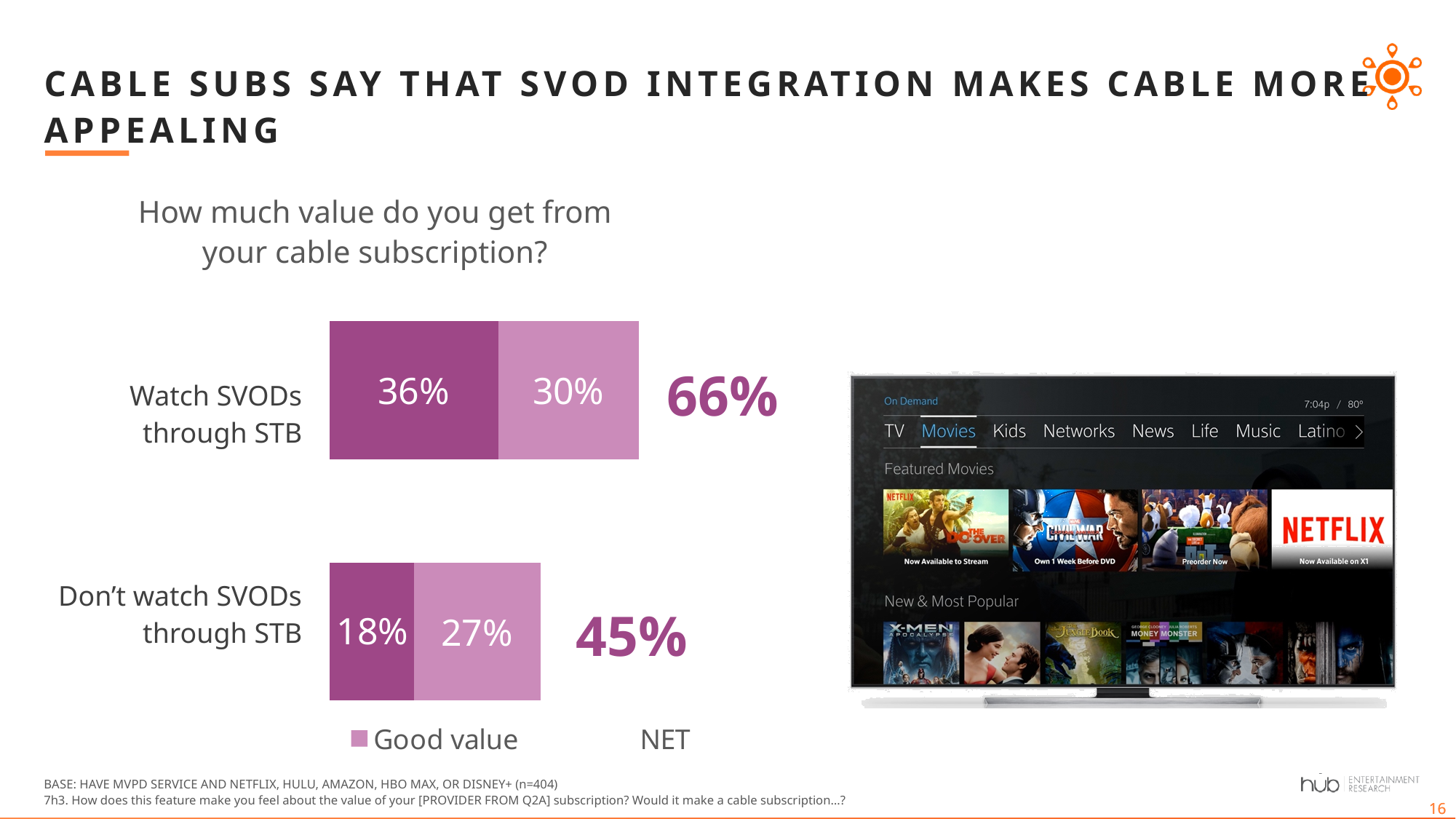
What question is the chart titled with? How much value do you get from your cable subscription? What is the value of the darker left segment for 'Don't watch SVODs through STB'? 18% How many categories are shown in the bar chart? 2 What is the NET value for 'Don't watch SVODs through STB'? 45% What is the difference between the NET values of the two categories? 21% What is the value of the lighter 'Good value' segment for 'Don't watch SVODs through STB'? 27% What is the NET value for 'Watch SVODs through STB'? 66% What is the difference between the darker left segments of the two categories (36% vs 18%)? 18% Which category has the higher NET value? Watch SVODs through STB Which is larger: the 'Good value' segment for 'Watch SVODs through STB' or for 'Don't watch SVODs through STB'? Watch SVODs through STB What is the value of the lighter 'Good value' segment for 'Watch SVODs through STB'? 30% What type of chart is shown on the slide? Stacked bar chart